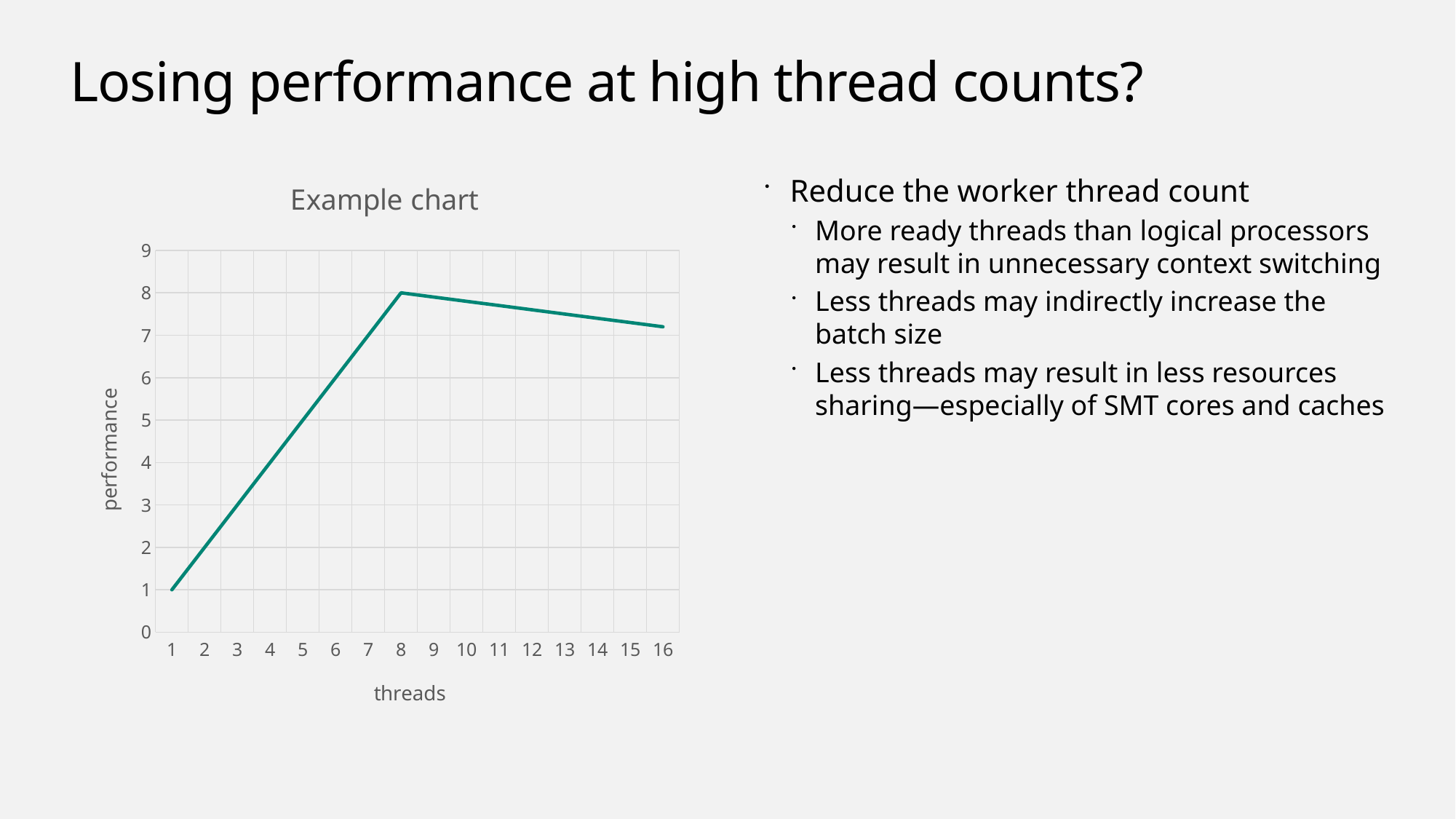
Does performance rise or fall as threads increase from 8 to 16? fall What is the title of the chart? Example chart What is the performance value at 1 thread? 1 At how many threads does the line reach its highest performance? 8 How many thread counts are marked on the x axis? 16 Is the performance value at 16 threads greater or less than 7? greater What is the label of the x axis of the chart? threads What is the performance value at 8 threads? 8 What kind of chart is shown on the slide? line chart At how many threads is the performance lowest? 1 Which has higher performance: 8 threads or 16 threads? 8 threads Is the performance value at 16 threads greater or less than 8? less